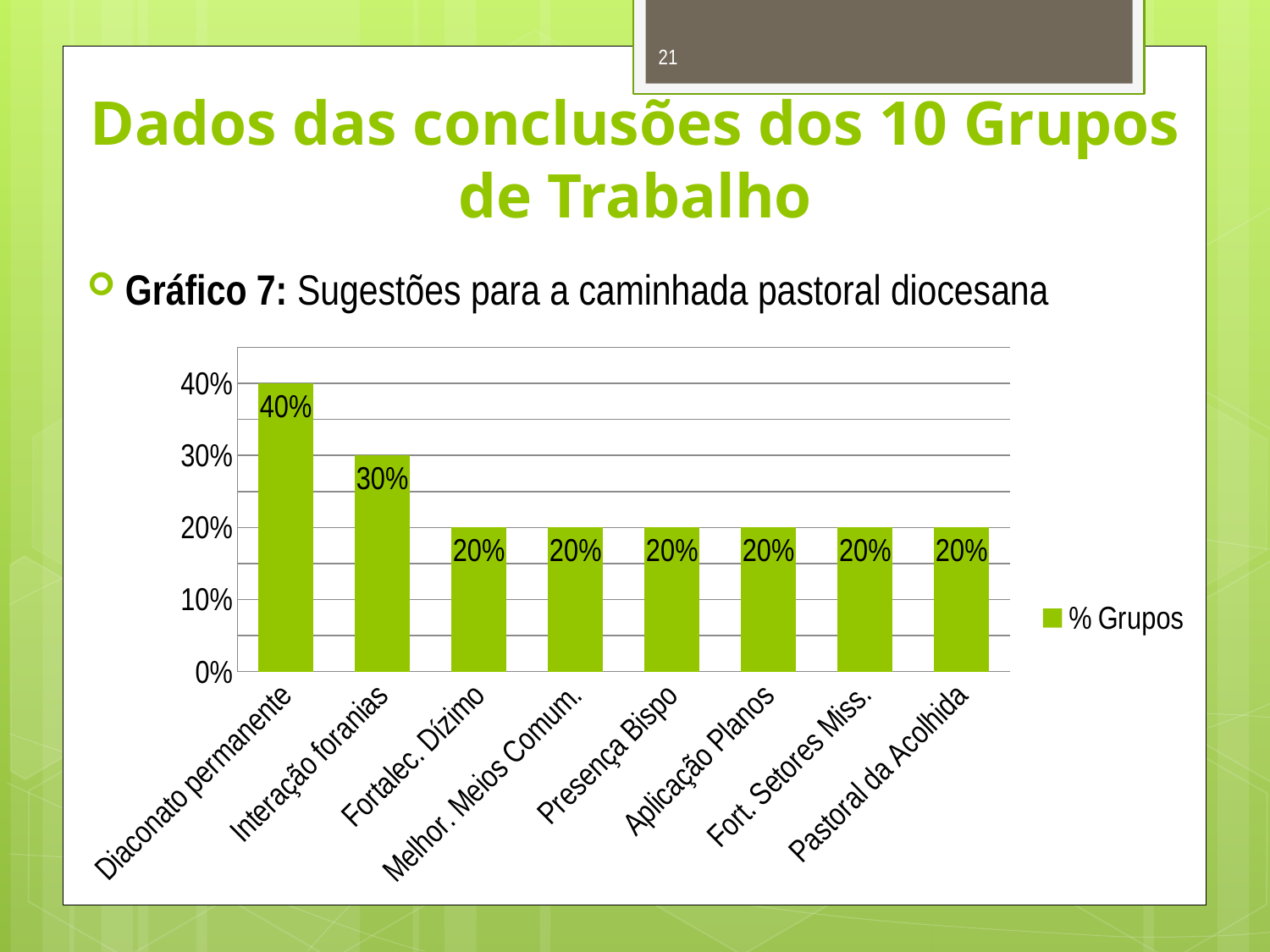
What is the difference between the values for Interação foranias and Fortalec. Dízimo? 10% What is the difference between the values for Diaconato permanente and Interação foranias? 10% Which category has the highest value? Diaconato permanente What kind of chart is shown on the slide? bar chart What is the value for Presença Bispo? 20% What is the name of the series shown in the legend? % Grupos How many categories are shown on the x axis? 8 Is the value for Diaconato permanente greater or less than 30%? greater What is the value for Interação foranias? 30% What is the value for Diaconato permanente? 40% How many series does the legend list? 1 Which is larger, the value for Interação foranias or the value for Pastoral da Acolhida? Interação foranias